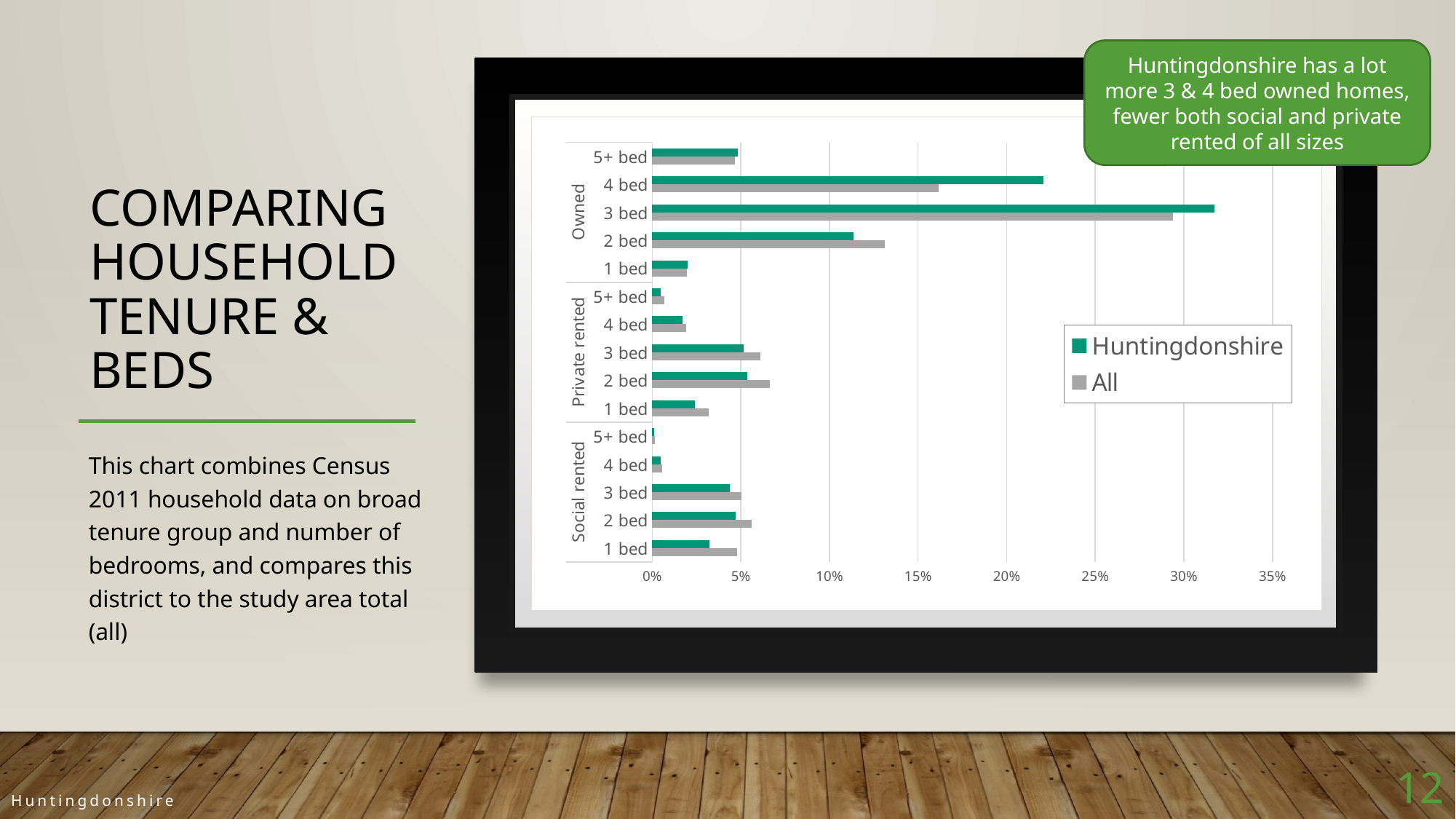
How many series does the chart legend list? 2 Which category has the lowest Huntingdonshire value? Social rented 5+ bed For Private rented 2 bed, which series has the larger value, Huntingdonshire or All? All What are the two series named in the legend? Huntingdonshire and All How many bedroom categories are plotted in total across all tenure groups? 15 Is the Huntingdonshire value for Owned 2 bed greater or less than 10%? greater For Owned 4 bed, which series has the larger value, Huntingdonshire or All? Huntingdonshire Is the Huntingdonshire value for Social rented 3 bed greater or less than 5%? less Is the Huntingdonshire value for Owned 4 bed greater or less than 20%? greater How many tenure groups are shown on the vertical axis of the chart? 3 What kind of chart is shown on the slide? Bar chart Which category has the highest Huntingdonshire value? Owned 3 bed